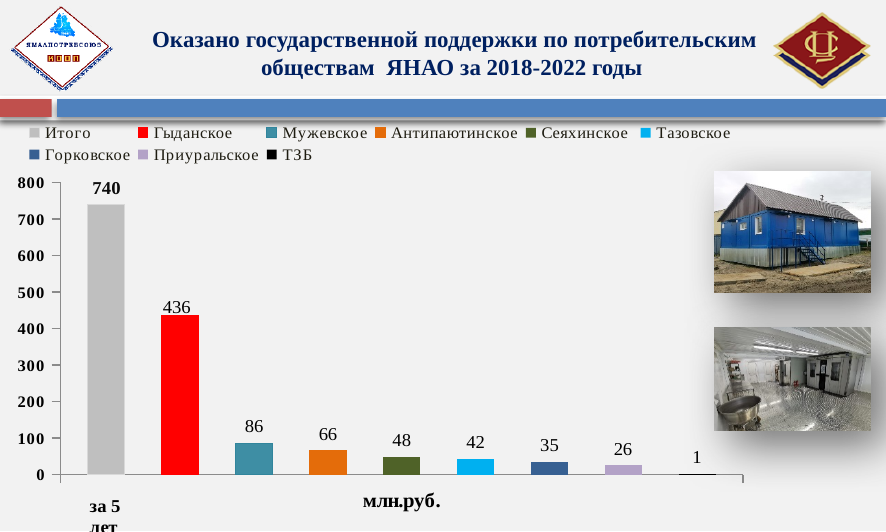
What is the value for ТЗБ? 1 Which series has the lowest value? ТЗБ What is the value for Тазовское? 42 What is the value shown for Итого? 740 What is the value for Мужевское? 86 Excluding Итого, which series has the highest value? Гыданское Which is larger, the value for Антипаютинское or the value for Сеяхинское? Антипаютинское What is the difference between the values for Гыданское and Мужевское? 350 How many series does the legend list? 9 What is the value for Гыданское? 436 What unit is shown below the x axis of the chart? млн.руб. What kind of chart is shown on the slide? bar chart